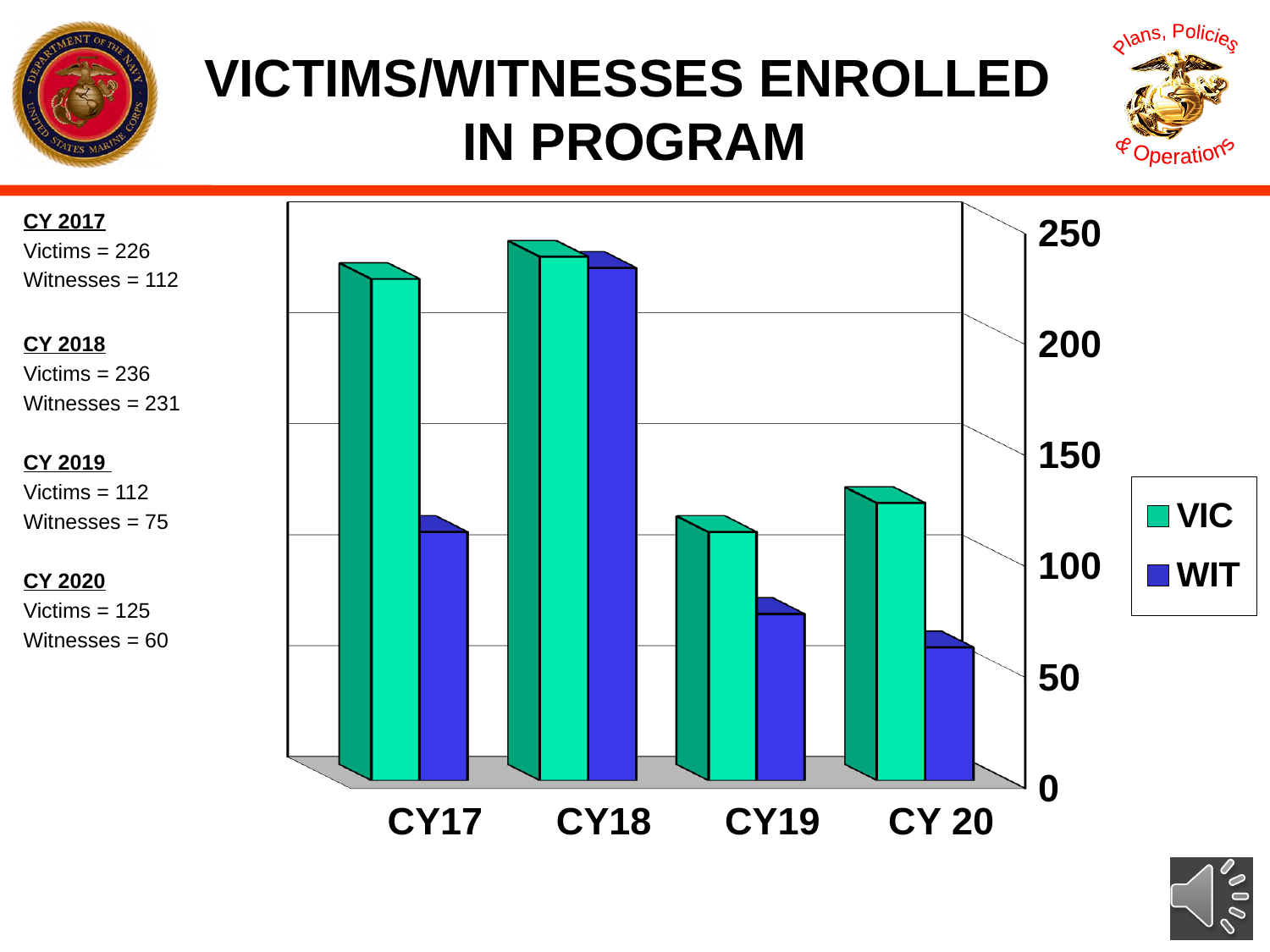
What is the difference between victims and witnesses in CY19? 37 What is the number of witnesses enrolled in CY17? 112 Which year has the lowest WIT value? CY 20 What is the number of witnesses enrolled in CY20? 60 Which legend entry is shown in blue? WIT Which year has the highest VIC value? CY18 What kind of chart is shown on the slide? bar chart Which is larger in CY17, the VIC bar or the WIT bar? VIC What is the number of victims enrolled in CY18? 236 How many calendar-year categories are shown on the x axis? 4 How many series does the legend list? 2 Is the WIT value for CY18 greater or less than 200? greater